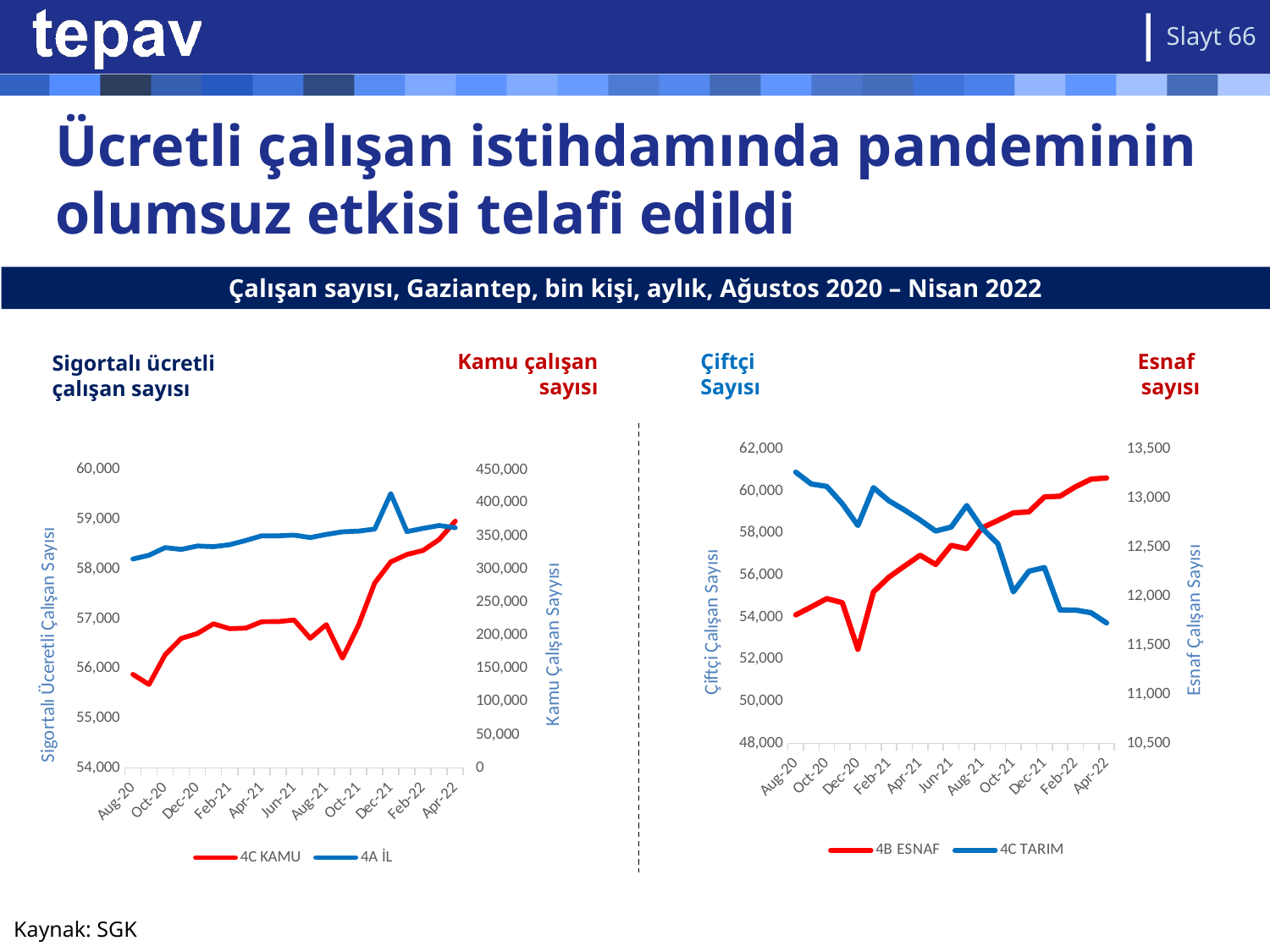
What kind of chart is the right chart (Çiftçi Sayısı / Esnaf sayısı)? Line chart What source is cited for the charts on the slide? SGK In the left chart, which series is drawn in blue? 4A İL How many series does the legend of the right chart list? 2 In the left chart, does the 4C KAMU series rise or fall overall from Aug-20 to Apr-22? Rise In the right chart, does the 4B ESNAF series rise or fall overall from Aug-20 to Apr-22? Rise How many series does the legend of the left chart list? 2 In the right chart, does the 4C TARIM series rise or fall overall from Aug-20 to Apr-22? Fall What kind of chart is the left chart (Sigortalı ücretli çalışan sayısı / Kamu çalışan sayısı)? Line chart